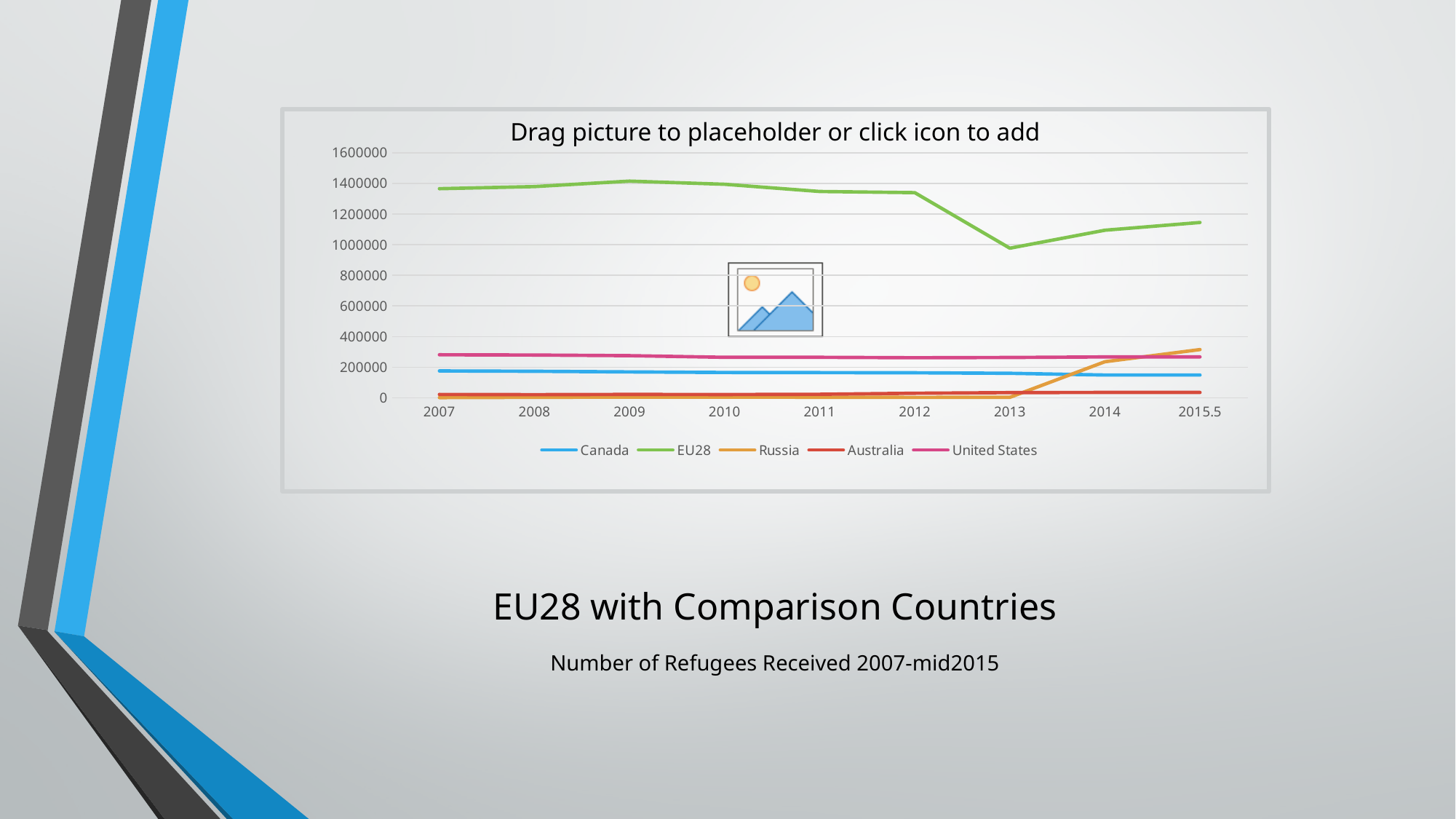
Which series is drawn with a green line? EU28 How many points are plotted along the x axis for each series? 9 What kind of chart is shown on the slide? Line chart Is the value for EU28 in 2012 greater or less than 1200000? greater Does the Russia series rise or fall between 2013 and 2015.5? Rise How many series does the legend list? 5 Is the value for Russia at 2015.5 greater or less than 200000? greater Which series has the lowest value at 2015.5? Australia Is the value for Canada in 2007 greater or less than 200000? less Which is larger in 2010, the value for United States or the value for Canada? United States Which series has the highest values across the whole chart? EU28